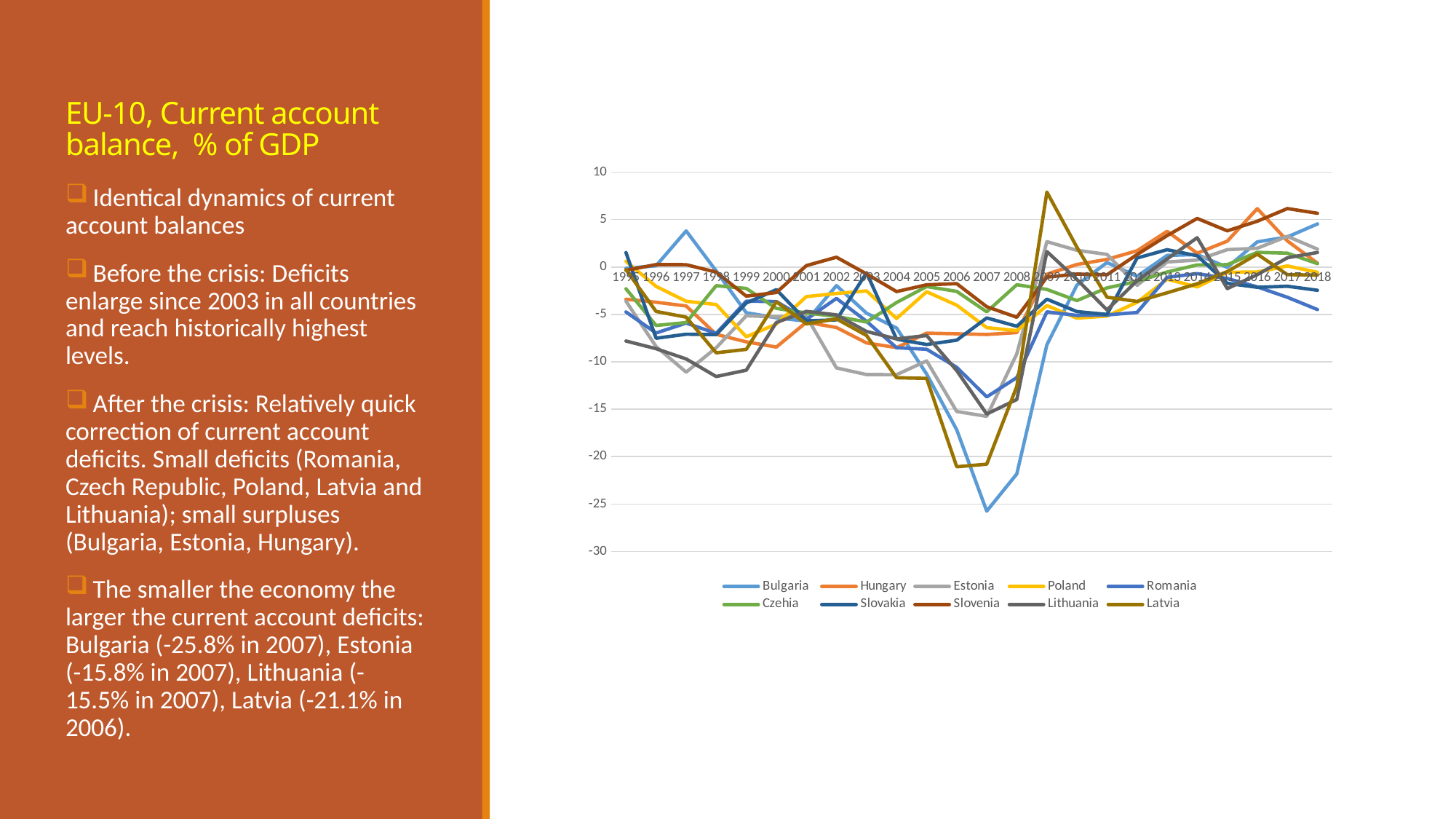
How many series does the legend list? 10 Is the value for Bulgaria in 2007 greater or less than -20? less Is the value for Latvia in 2009 greater or less than 5? greater How many years are shown on the x axis? 24 Is the value for Estonia in 2007 greater or less than -10? less What is the lowest value shown on the y axis? -30 Does the Bulgaria line rise or fall between 2007 and 2009? rise What kind of chart is shown on the slide? line chart Which country has the lowest value in 2007? Bulgaria Which country has the highest value in 2009? Latvia